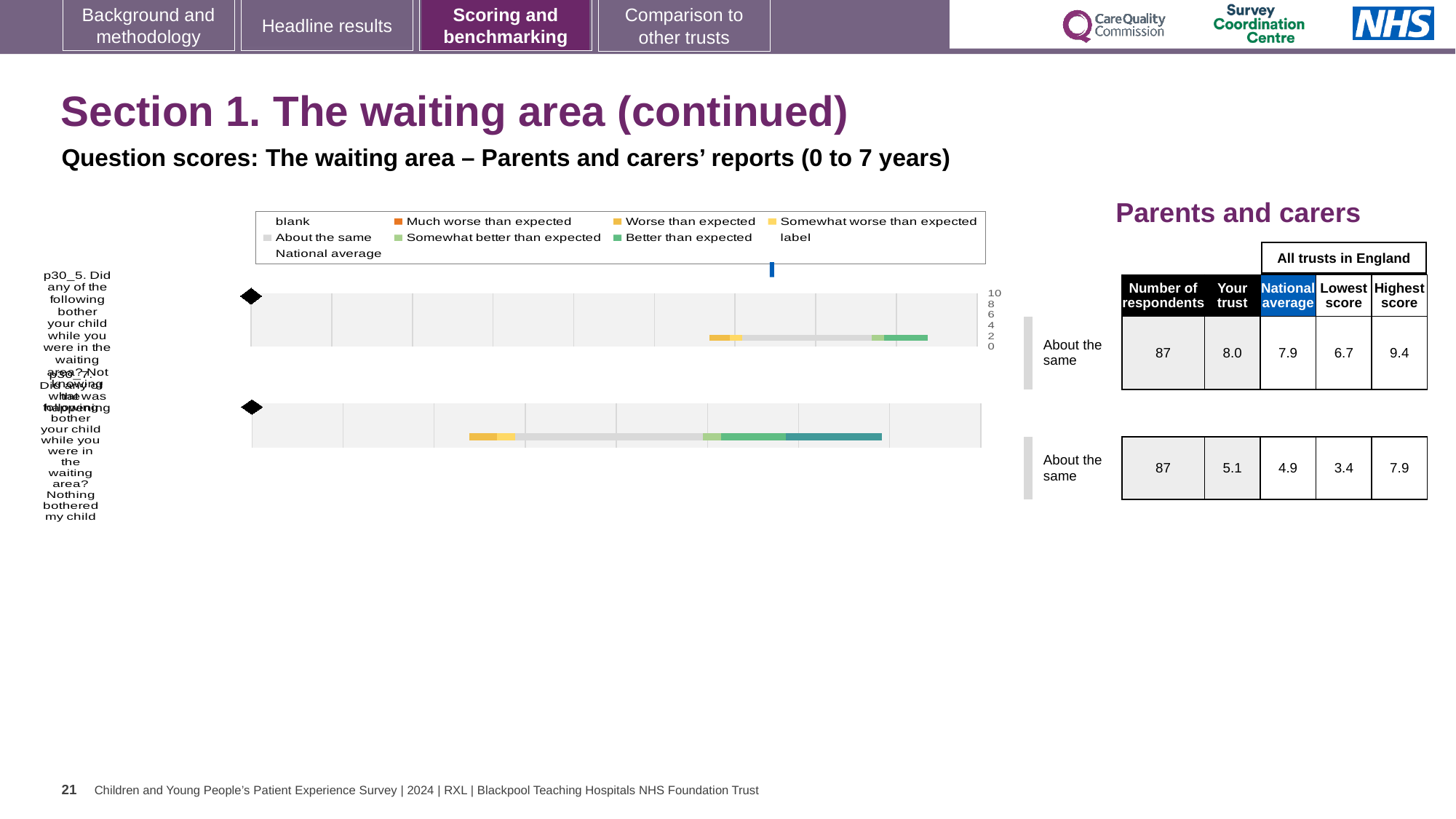
What is the difference between the 'Your trust' score and the national average for question p30_5? 0.1 How many questions (bars) are plotted in the chart? 2 How many respondents answered question p30_5? 87 What is the highest value shown on the chart's score axis? 10 What is the difference between the highest and lowest scores for question p30_7? 4.5 Which legend entry is shown in orange? Much worse than expected What is the lowest score across all trusts in England for question p30_7? 3.4 What is the national average score for question p30_7 (Nothing bothered my child)? 4.9 What kind of chart is shown on the slide? bar chart Which question has the higher 'Your trust' score, p30_5 or p30_7? p30_5 What benchmark category is given for question p30_5? About the same What is the 'Your trust' score for question p30_5 (Not knowing what was happening)? 8.0